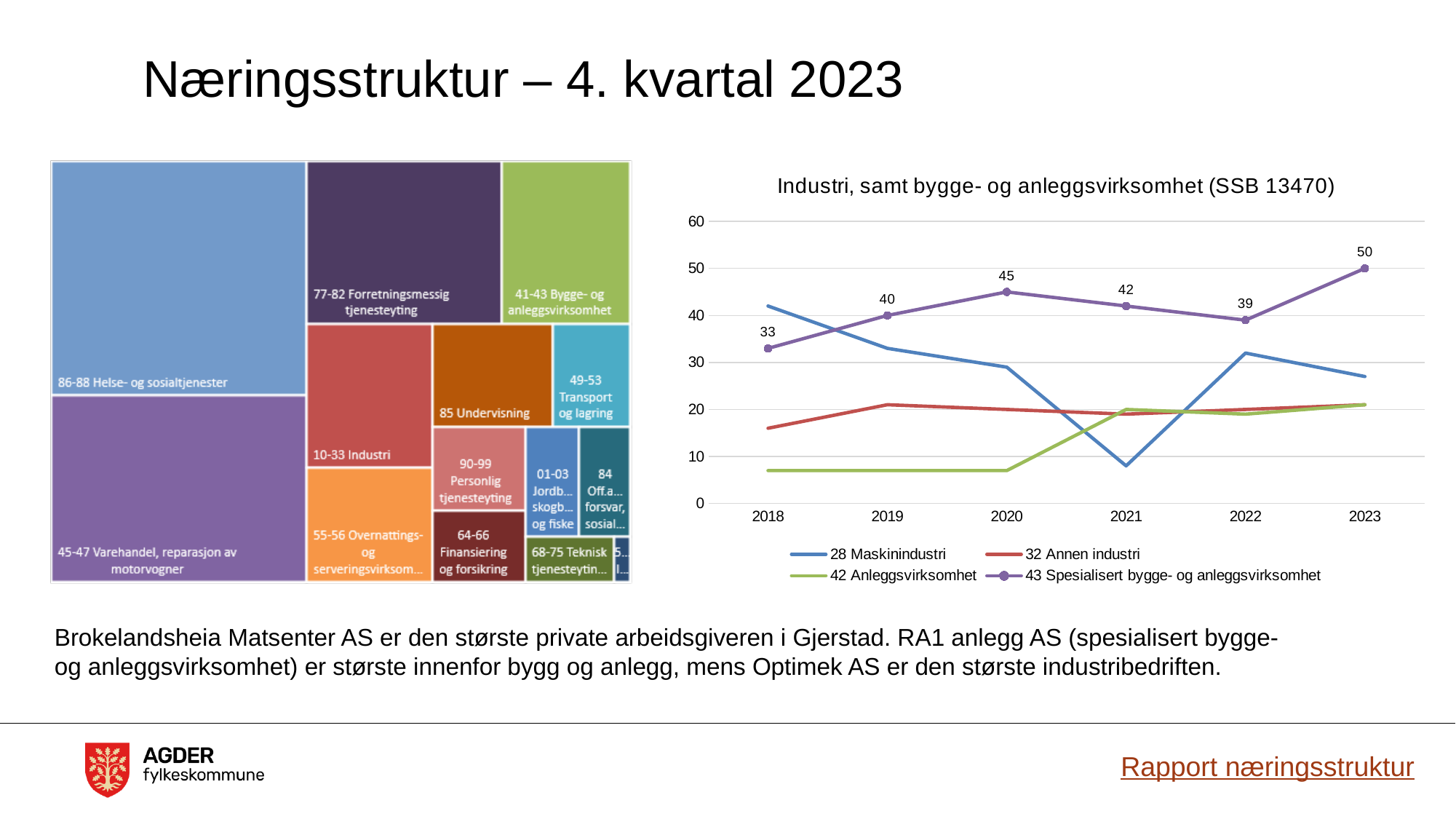
In the line chart 'Industri, samt bygge- og anleggsvirksomhet (SSB 13470)', how many series does the legend list? 4 In the line chart 'Industri, samt bygge- og anleggsvirksomhet (SSB 13470)', what is the value for 43 Spesialisert bygge- og anleggsvirksomhet in 2018? 33 In the line chart 'Industri, samt bygge- og anleggsvirksomhet (SSB 13470)', does the value for 42 Anleggsvirksomhet rise or fall from 2018 to 2023? rise In the line chart 'Industri, samt bygge- og anleggsvirksomhet (SSB 13470)', in which year is 43 Spesialisert bygge- og anleggsvirksomhet highest? 2023 In the line chart 'Industri, samt bygge- og anleggsvirksomhet (SSB 13470)', is the value for 43 Spesialisert bygge- og anleggsvirksomhet larger in 2019 or in 2022? 2019 In the line chart 'Industri, samt bygge- og anleggsvirksomhet (SSB 13470)', in which year is 43 Spesialisert bygge- og anleggsvirksomhet lowest? 2018 In the line chart 'Industri, samt bygge- og anleggsvirksomhet (SSB 13470)', what is the difference between the 2020 and 2021 values for 43 Spesialisert bygge- og anleggsvirksomhet? 3 In the line chart 'Industri, samt bygge- og anleggsvirksomhet (SSB 13470)', by how much did 43 Spesialisert bygge- og anleggsvirksomhet increase from 2018 to 2023? 17 In the line chart 'Industri, samt bygge- og anleggsvirksomhet (SSB 13470)', is the value for 28 Maskinindustri in 2018 greater or less than 30? greater In the line chart 'Industri, samt bygge- og anleggsvirksomhet (SSB 13470)', how many years are shown on the x axis? 6 In the line chart 'Industri, samt bygge- og anleggsvirksomhet (SSB 13470)', is the value for 28 Maskinindustri in 2021 greater or less than 10? less In the line chart 'Industri, samt bygge- og anleggsvirksomhet (SSB 13470)', what is the value for 43 Spesialisert bygge- og anleggsvirksomhet in 2023? 50